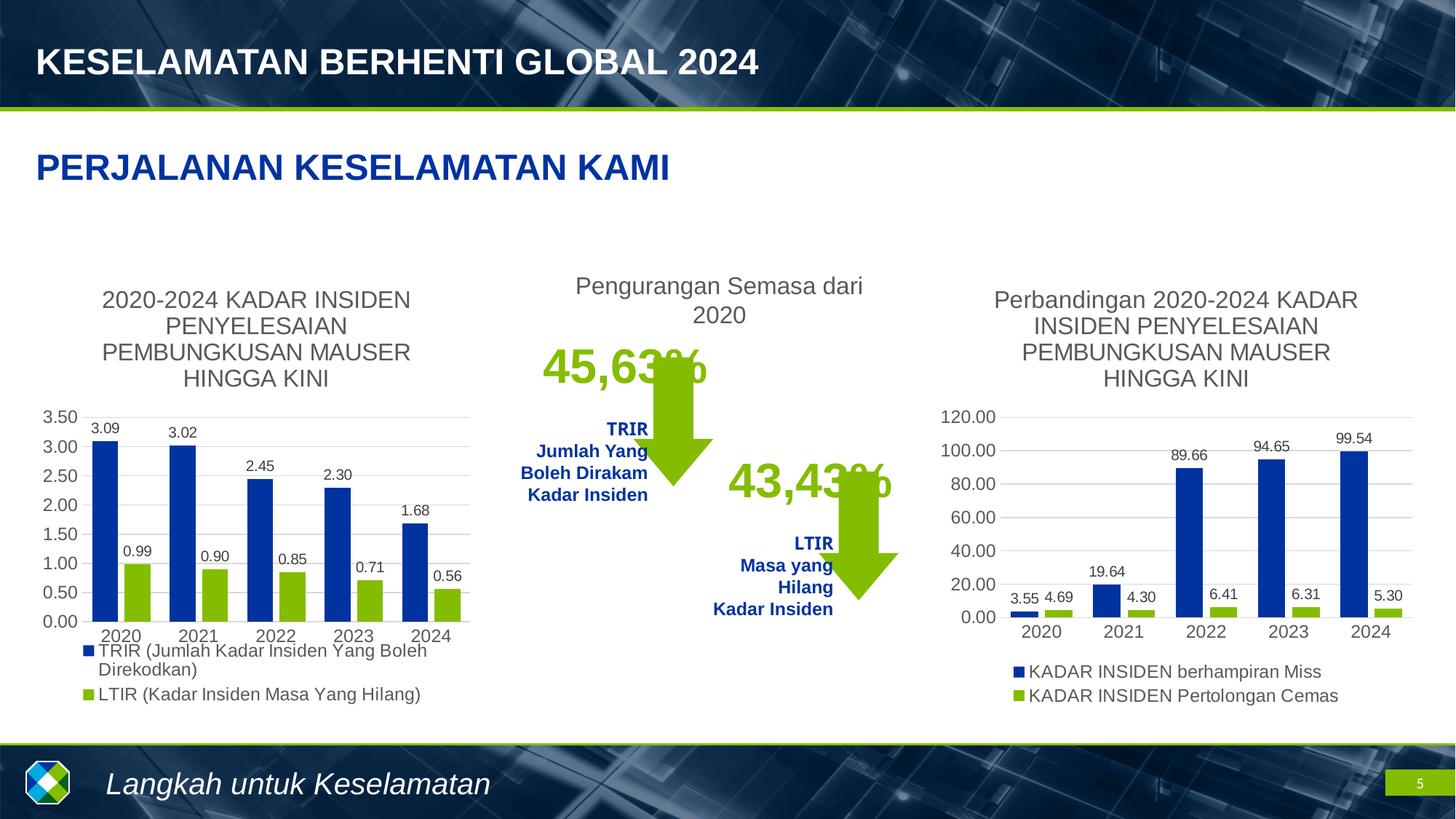
In the right chart, what is the KADAR INSIDEN berhampiran Miss value for 2022? 89.66 In the left chart, does the TRIR series rise or fall from 2020 to 2024? fall What type of chart is the right chart? bar chart In the right chart, which is larger: the KADAR INSIDEN Pertolongan Cemas value for 2022 or for 2024? 2022 In the left chart, how many series does the legend list? 2 In the right chart, which year has the highest KADAR INSIDEN berhampiran Miss value? 2024 In the left chart, what is the LTIR value for 2024? 0.56 In the right chart, what is the difference between the KADAR INSIDEN berhampiran Miss values for 2024 and 2023? 4.89 How many years are shown on the x axis of the right chart? 5 In the left chart, what is the difference between the TRIR values for 2020 and 2024? 1.41 In the left chart, which year has the lowest TRIR value? 2024 In the left chart, what is the TRIR value for 2020? 3.09